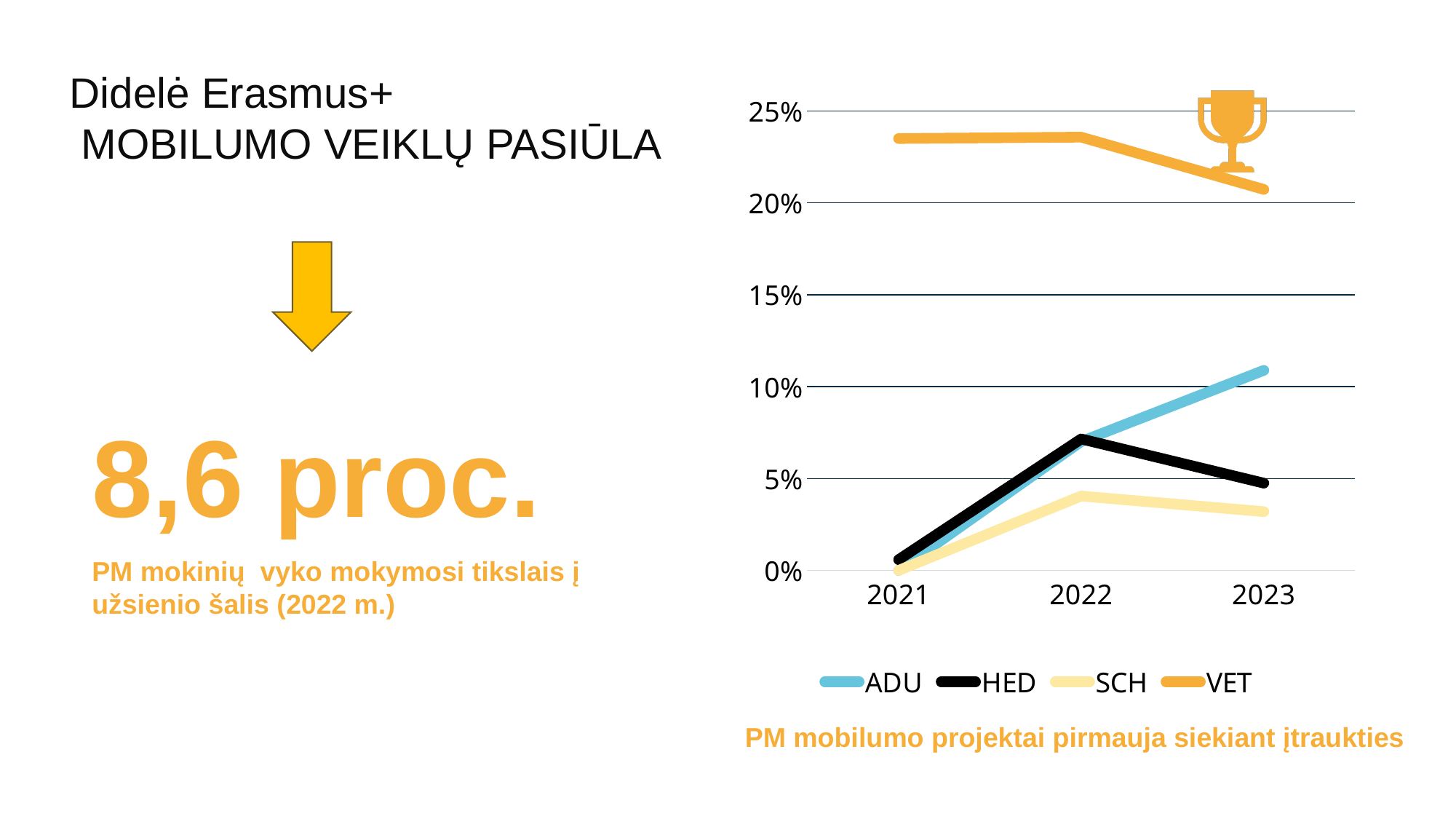
Which is larger in 2023, the value for ADU or the value for HED? ADU Is the value for SCH in 2022 greater or less than 5%? less How many years are shown on the x axis of the chart? 3 What kind of chart is shown on the slide? line chart Which series has the highest value in 2023? VET Does the VET line rise or fall from 2022 to 2023? fall Does the ADU line rise or fall from 2021 to 2023? rise Which series is drawn in black in the chart? HED Is the value for HED in 2022 greater or less than 5%? greater Which series has the lowest value in 2023? SCH Is the value for VET in 2021 greater or less than 20%? greater How many series does the chart legend list? 4